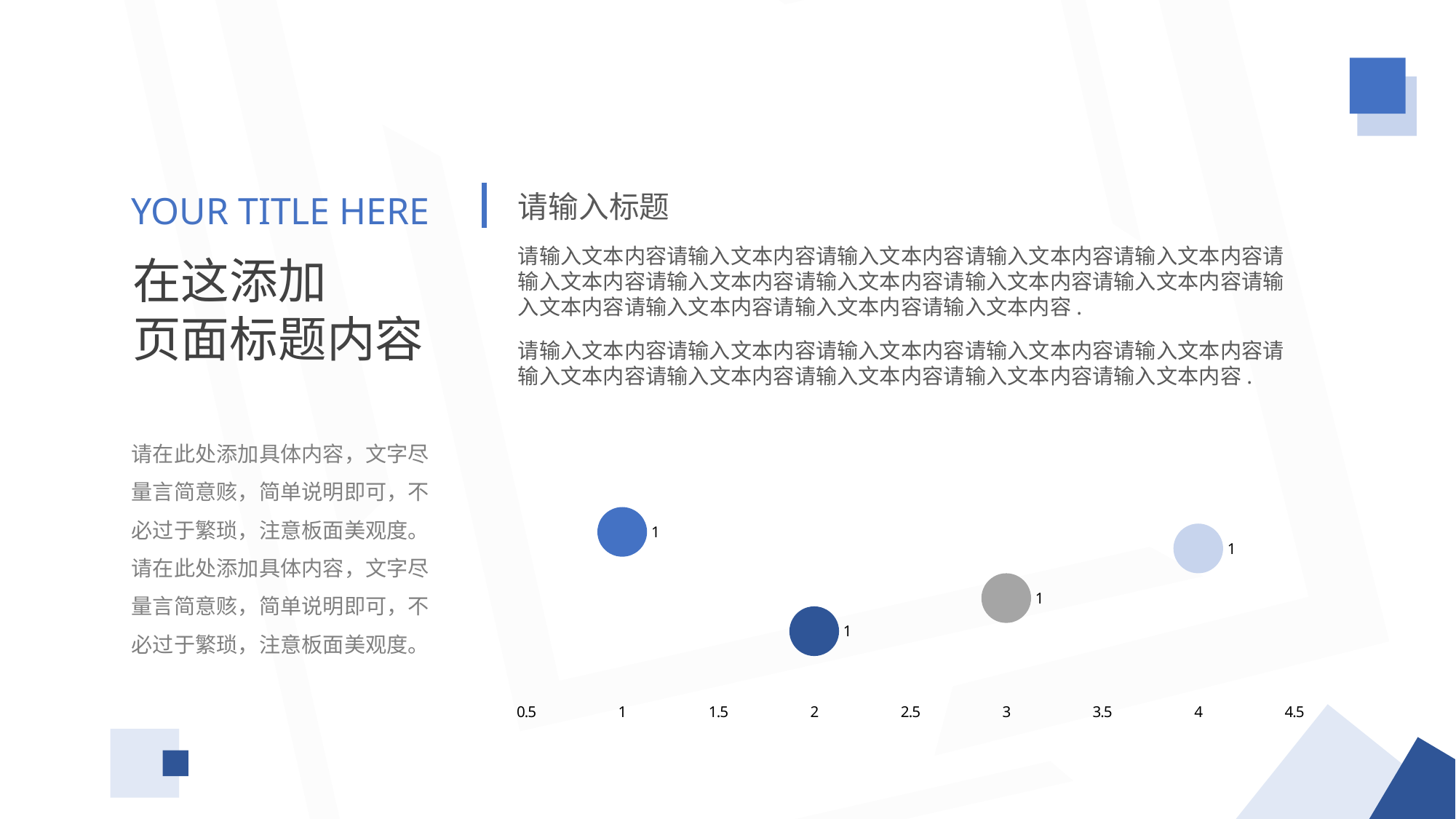
What kind of chart is shown on the slide? bubble chart What data label is shown next to the bubble at x = 4? 1 What is the highest value shown on the x axis? 4.5 What data label is shown next to the bubble at x = 3? 1 How many bubbles are plotted on the chart? 4 What data label is shown next to the bubble at x = 2? 1 How many tick labels are shown on the x axis? 9 What data label is shown next to the bubble at x = 1? 1 Do all four bubbles carry the same data label? yes What is the lowest value shown on the x axis? 0.5